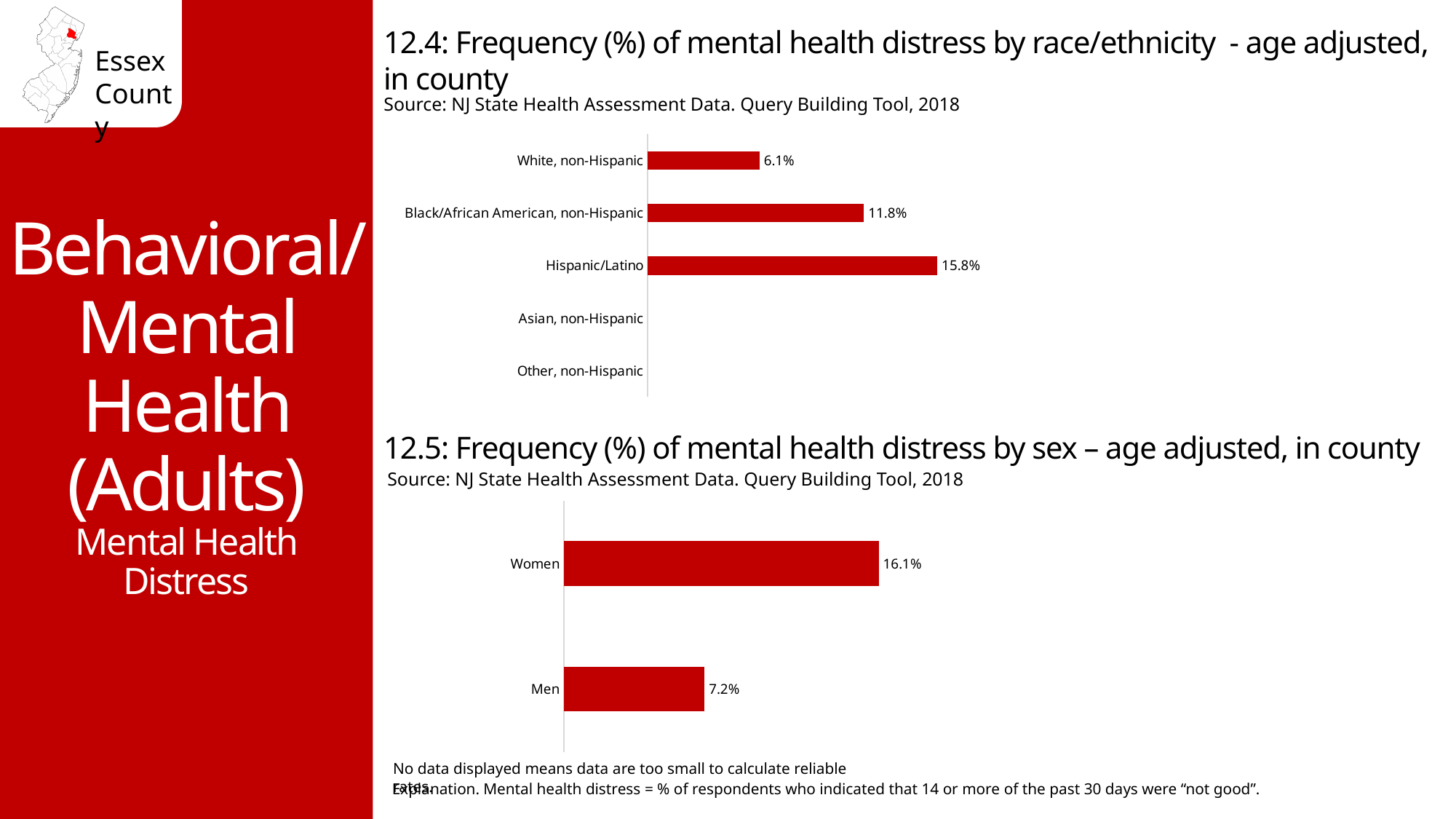
In chart 12.5 (mental health distress by sex), what is the value for Women? 16.1% In chart 12.4 (mental health distress by race/ethnicity), what is the difference between the Hispanic/Latino and White, non-Hispanic values? 9.7% In chart 12.4 (mental health distress by race/ethnicity), what is the value for White, non-Hispanic? 6.1% In chart 12.4 (mental health distress by race/ethnicity), which group has the highest value? Hispanic/Latino In chart 12.5 (mental health distress by sex), what is the value for Men? 7.2% What type of chart is chart 12.5 (mental health distress by sex)? Bar chart In chart 12.5 (mental health distress by sex), which group has the higher value, Women or Men? Women In chart 12.4 (mental health distress by race/ethnicity), which categories have no bar displayed? Asian, non-Hispanic and Other, non-Hispanic In chart 12.4 (mental health distress by race/ethnicity), how many race/ethnicity categories are listed on the axis? 5 In chart 12.5 (mental health distress by sex), what is the difference between the Women and Men values? 8.9% In chart 12.4 (mental health distress by race/ethnicity), what is the value for Hispanic/Latino? 15.8% In chart 12.4 (mental health distress by race/ethnicity), what is the value for Black/African American, non-Hispanic? 11.8%